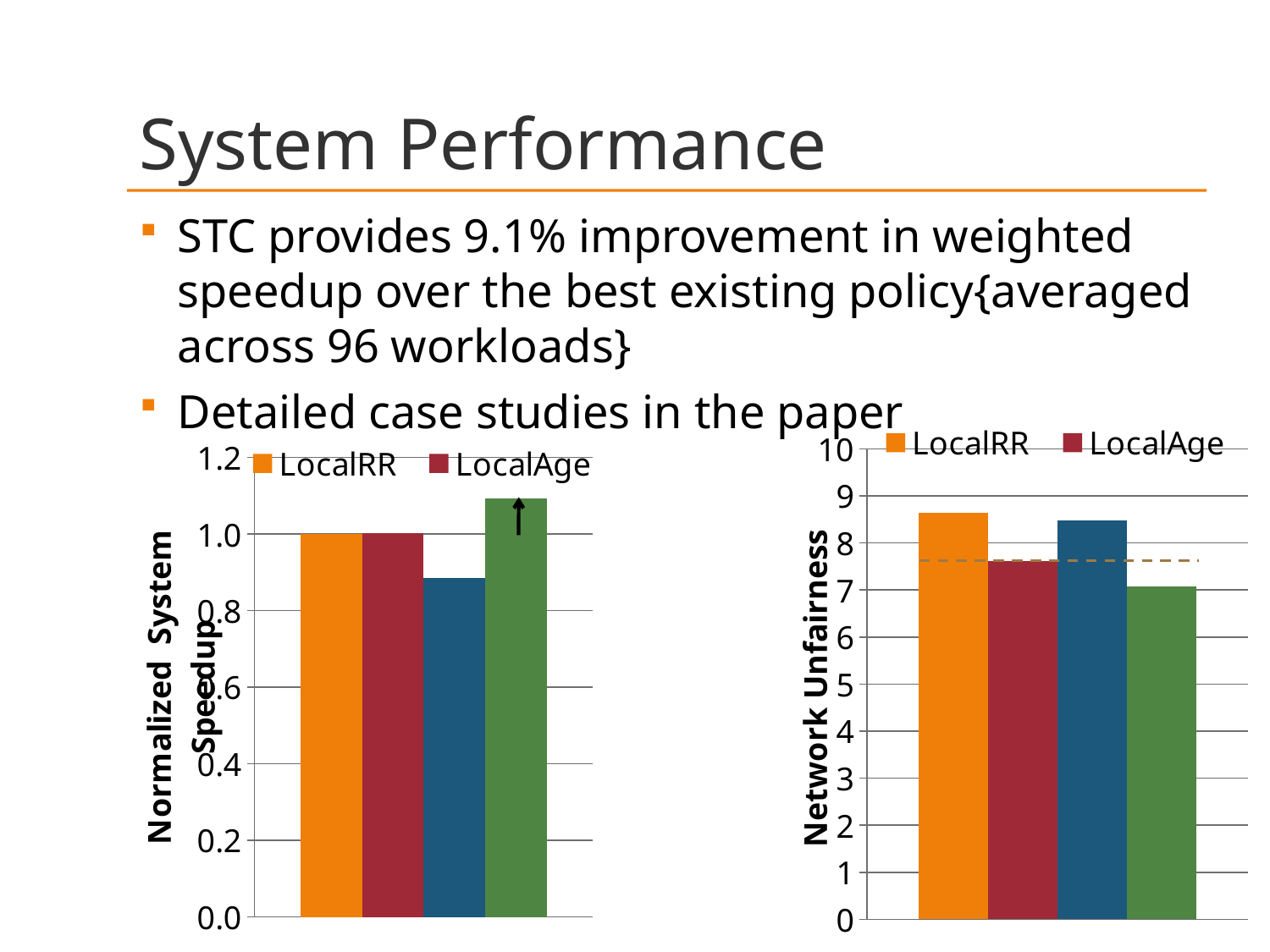
In the left chart (Normalized System Speedup), is the value of the blue bar greater or less than 1.0? less In the right chart (Network Unfairness), is the value for LocalAge greater or less than 8? less In the left chart (Normalized System Speedup), what is the value for LocalAge? 1.0 In the right chart (Network Unfairness), is the value for LocalRR greater or less than 8? greater What kind of chart is the left chart, labelled Normalized System Speedup? bar chart How many bars are plotted in the left chart (Normalized System Speedup)? 4 What is the y-axis title of the right chart? Network Unfairness In the left chart (Normalized System Speedup), what is the value for LocalRR? 1.0 In the right chart (Network Unfairness), which has the larger value, LocalRR or LocalAge? LocalRR How many series does the legend of the right chart (Network Unfairness) list? 2